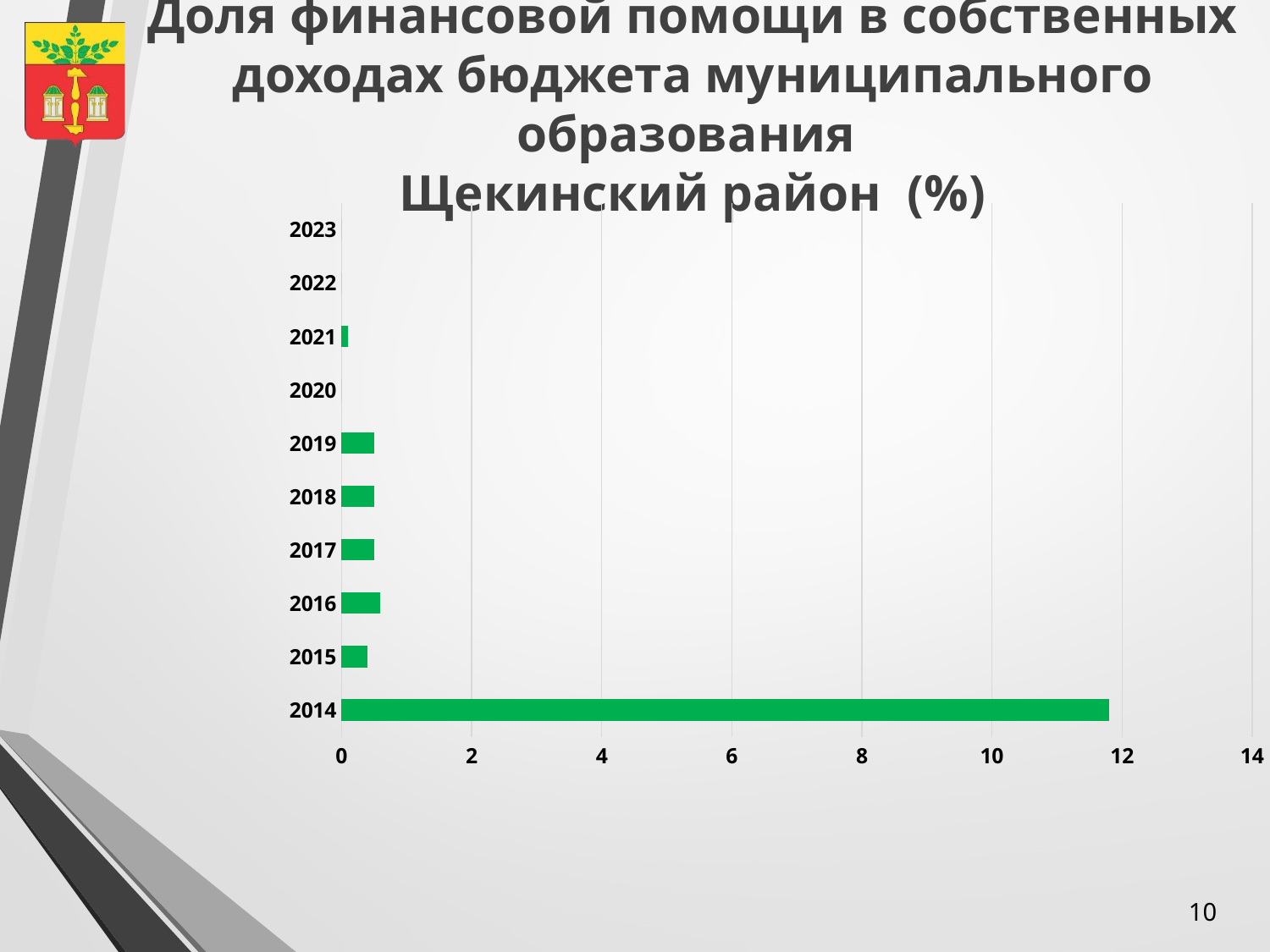
Is the value for 2014 greater or less than 12? less What is the highest value shown on the horizontal axis? 14 What colour are the bars on the chart? green Which year has the highest value on the chart? 2014 Is the value for 2014 greater or less than 10? greater What kind of chart is shown on the slide? bar chart Does the value rise or fall from 2014 to 2015? fall Is the value for 2016 greater or less than 2? less Which is larger, the value for 2016 or the value for 2021? 2016 How many years are shown on the chart? 10 Which is larger, the value for 2014 or the value for 2015? 2014